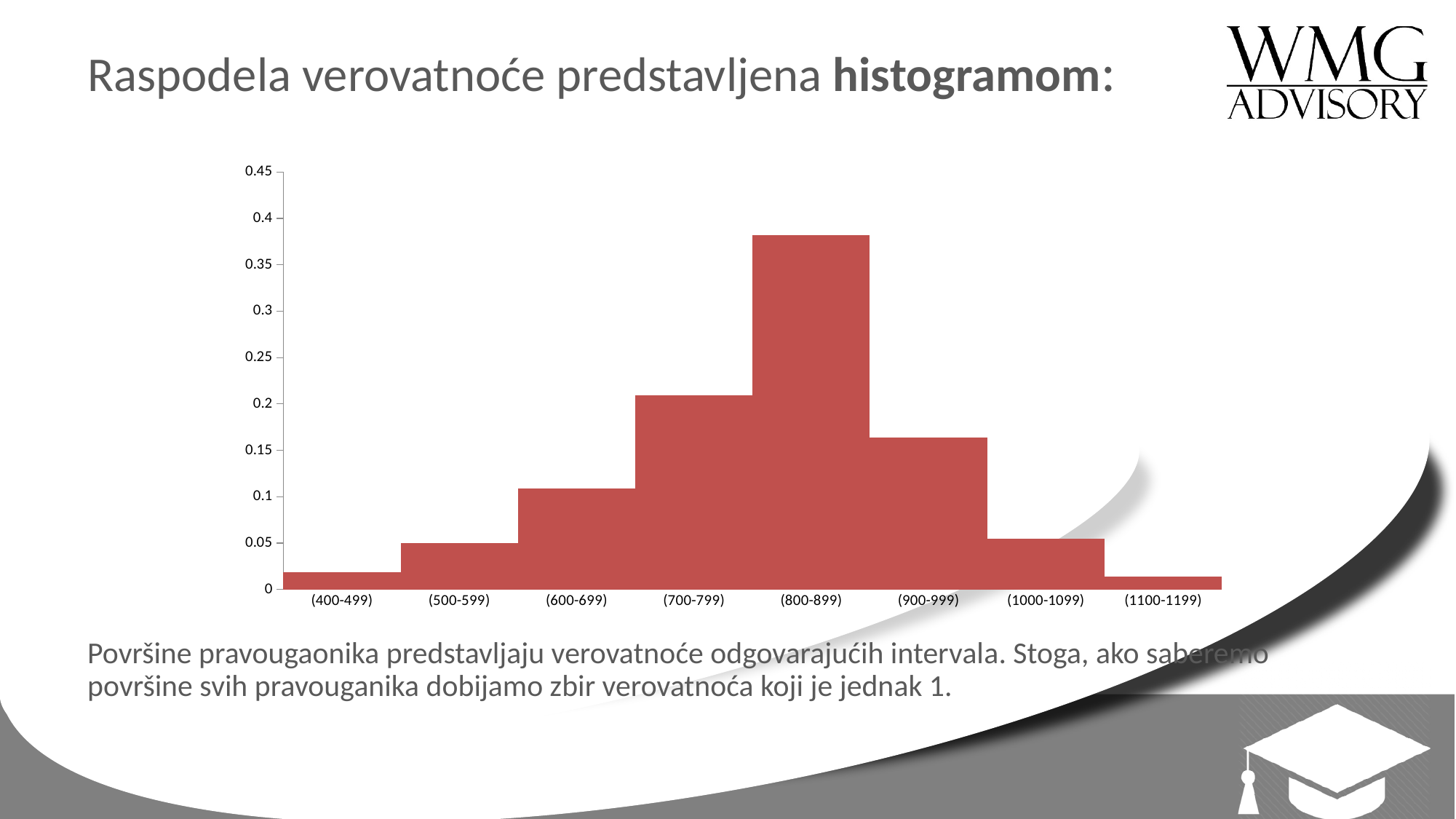
Is the value for (900-999) greater or less than 0.15? greater Do the values rise or fall from (400-499) to (800-899)? rise What kind of chart is shown on the slide? bar chart (histogram) Is the value for (1000-1099) greater or less than 0.1? less Is the value for (800-899) greater or less than 0.35? greater Which is larger, the value for (700-799) or the value for (900-999)? (700-799) How many interval categories are shown on the x axis? 8 What colour are the bars in the histogram? red Which interval has the highest bar? (800-899)